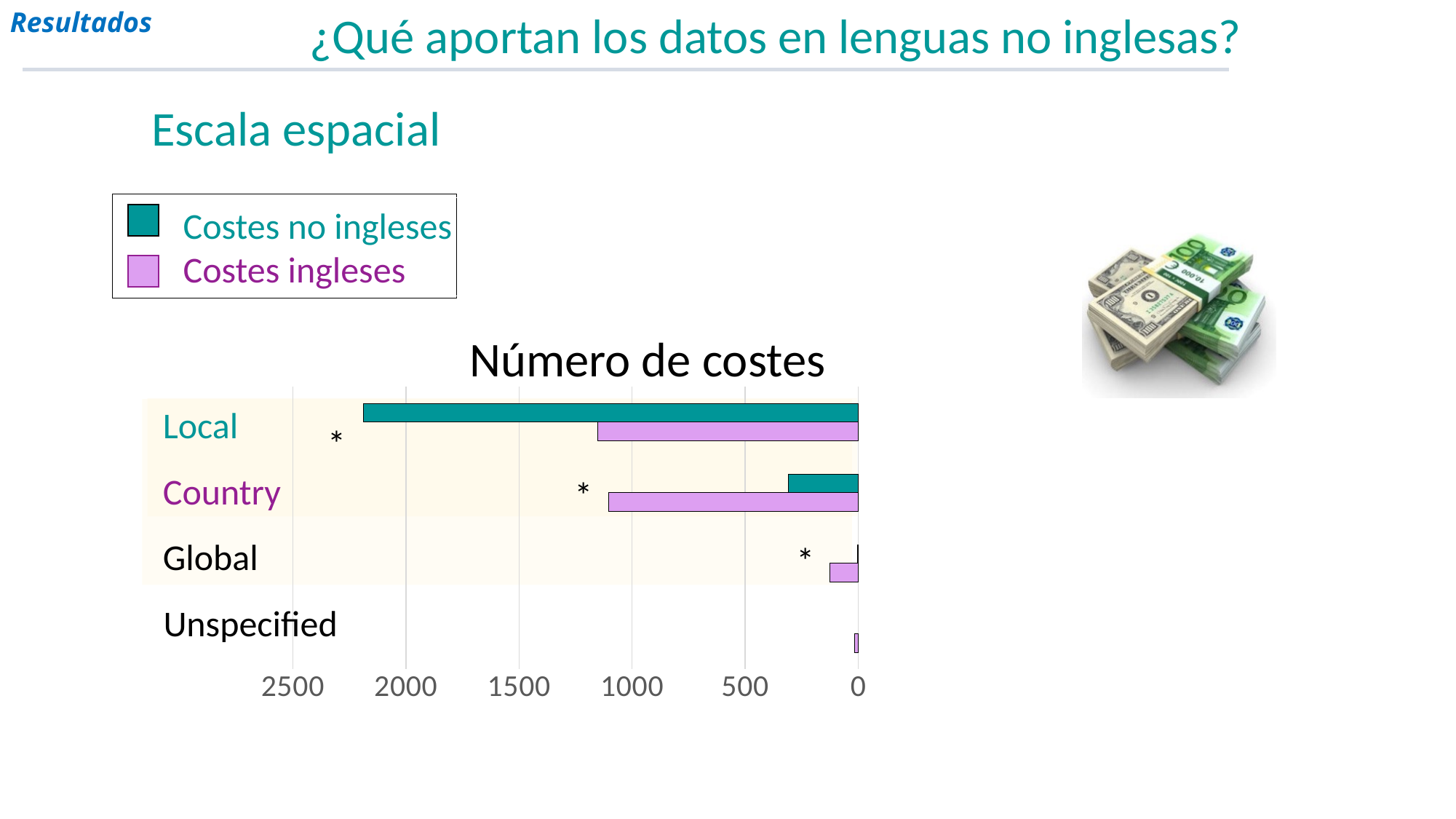
How many categories are shown on the "Número de costes" chart? 4 What kind of chart is shown under the title "Número de costes"? bar chart What is the title of the chart on the slide? Número de costes Which category has the highest value for "Costes no ingleses"? Local For the Local category, which series has the larger value, "Costes no ingleses" or "Costes ingleses"? Costes no ingleses For the Country category, which series has the larger value, "Costes no ingleses" or "Costes ingleses"? Costes ingleses Is the "Costes ingleses" value for Global greater or less than 500? less Is the "Costes no ingleses" value for Country greater or less than 500? less Which category has the lowest value for "Costes ingleses"? Unspecified Is the "Costes no ingleses" value for Local greater or less than 2000? greater How many series does the legend of the "Número de costes" chart list? 2